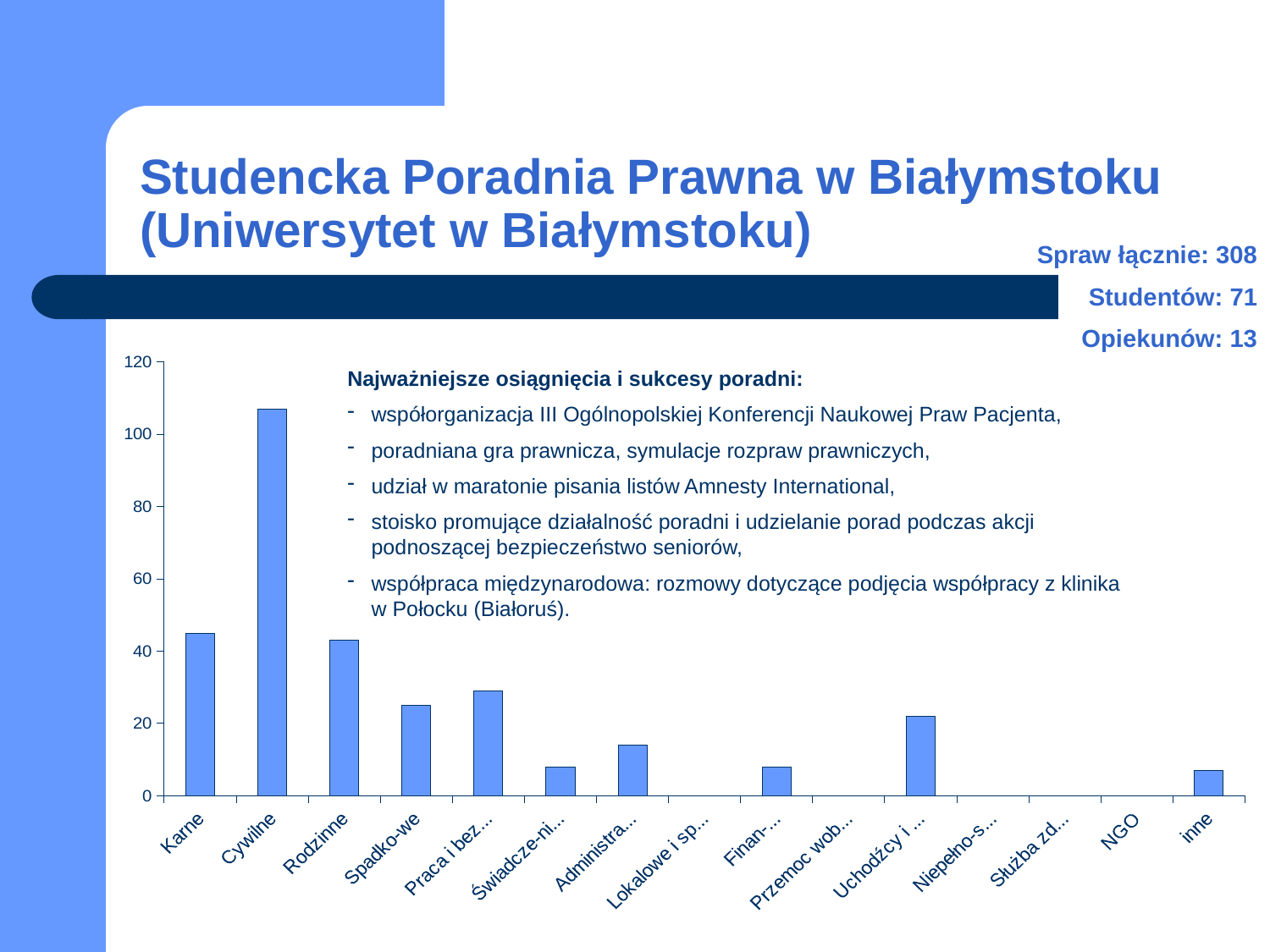
What colour are the bars in the chart? blue Which is larger, the value for Uchodźcy i ... or the value for inne? Uchodźcy i ... Is the value for Świadcze-ni... greater or less than 20? less What kind of chart is shown on the slide? bar chart Is the value for Karne greater or less than 60? less Is the value for Uchodźcy i ... greater or less than 40? less How many categories are shown along the x axis of the chart? 15 Which is larger, the value for Spadko-we or the value for Administra...? Spadko-we Which category has the highest bar in the chart? Cywilne Which is larger, the value for Cywilne or the value for Karne? Cywilne